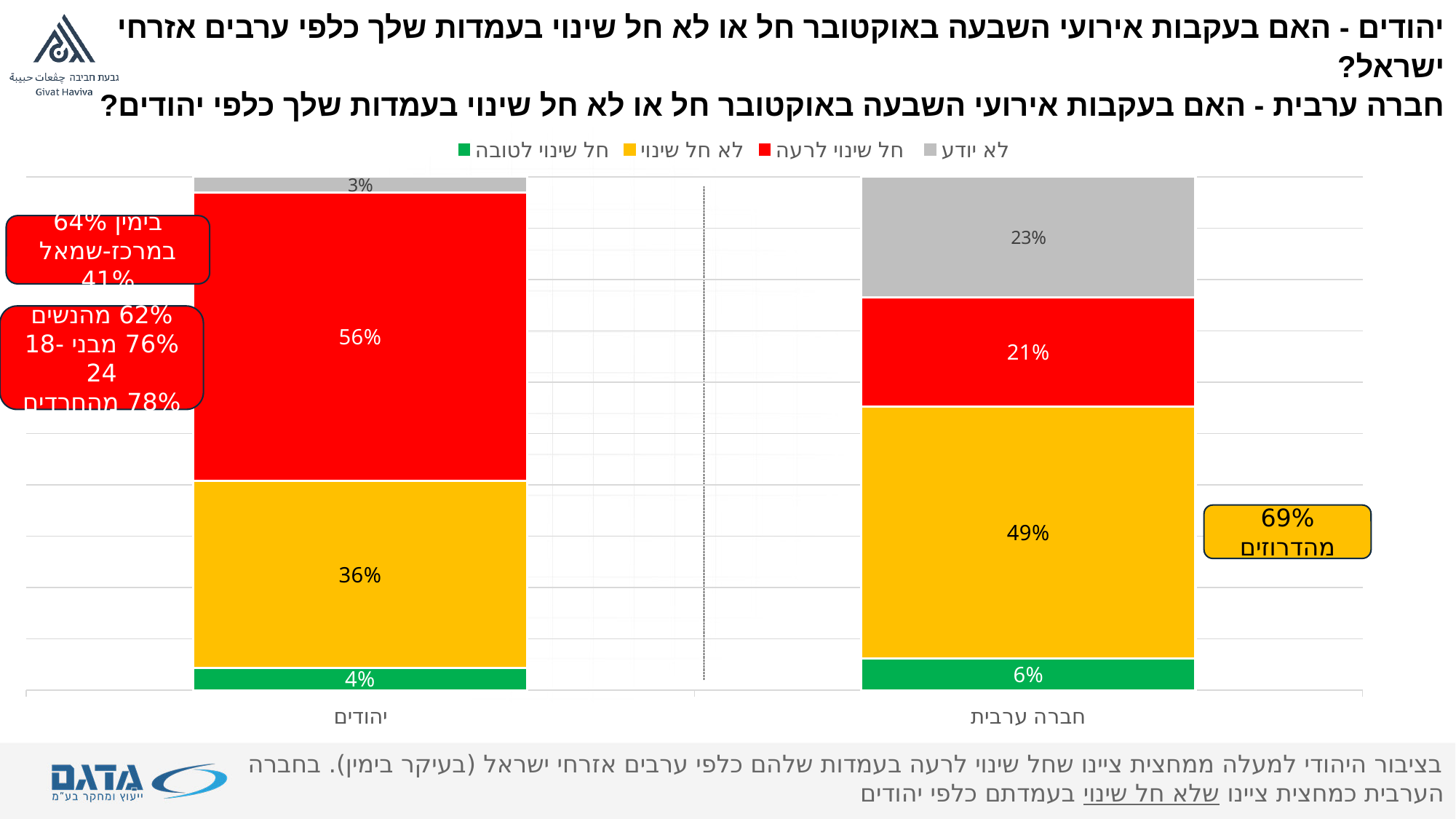
What percentage of חברה ערבית answered לא חל שינוי? 49% Which colour represents חל שינוי לרעה in the chart? Red Which response category is the largest among יהודים? חל שינוי לרעה Which response category is the smallest among חברה ערבית? חל שינוי לטובה Which group has a larger share of לא חל שינוי, יהודים or חברה ערבית? חברה ערבית What is the difference between the חל שינוי לרעה share for יהודים and for חברה ערבית? 35 percentage points What type of chart is shown on the slide? Stacked bar chart What percentage of יהודים answered חל שינוי לטובה? 4% What percentage of חברה ערבית answered לא יודע? 23% How many groups (bars) are shown on the x axis? 2 How many series does the legend list? 4 What percentage of יהודים answered חל שינוי לרעה? 56%